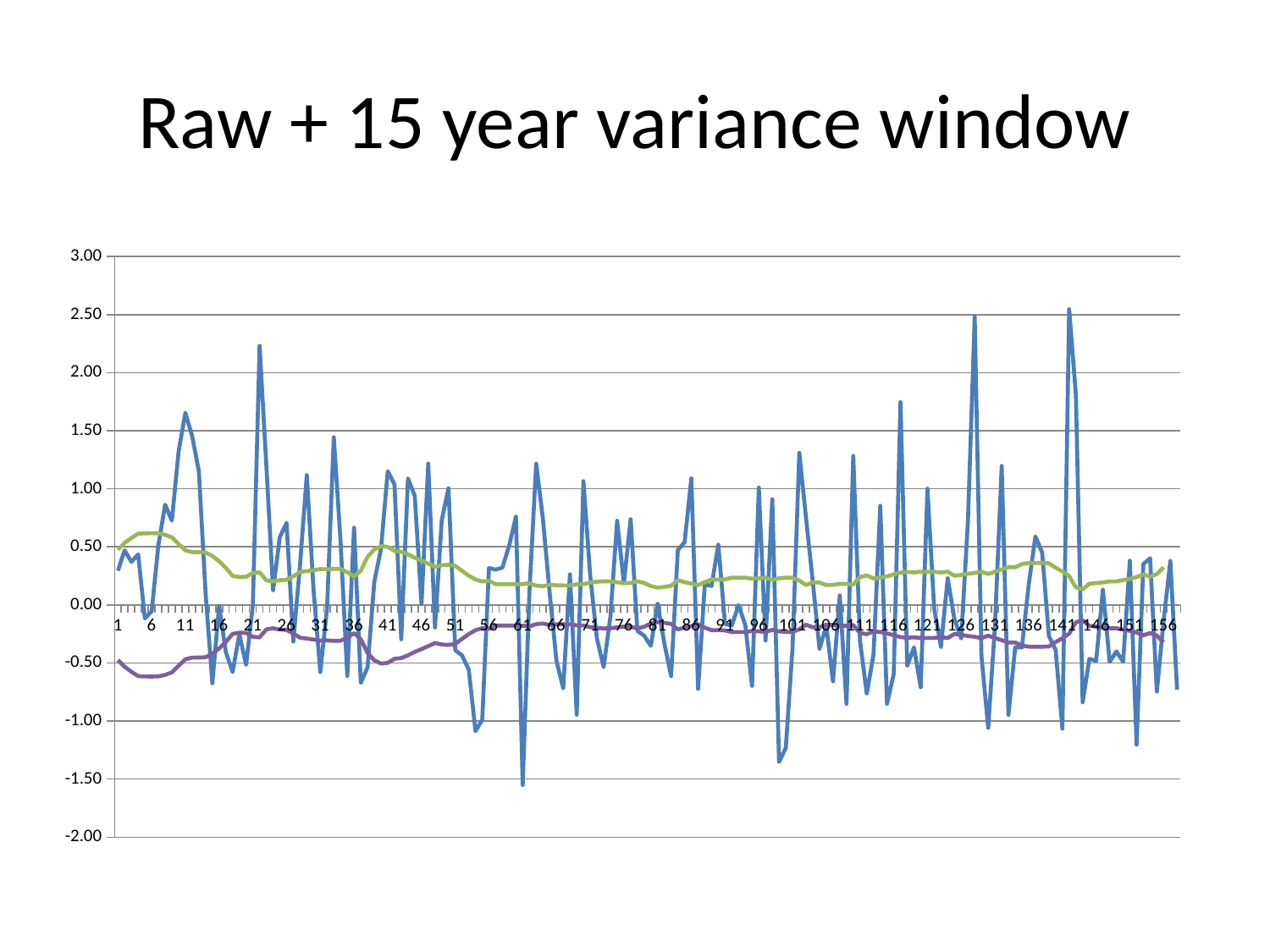
What is the lowest value labelled on the vertical axis? -2.00 Is the highest peak of the blue line, near x = 141, greater or less than 2.00? greater How many lines are plotted on the chart? 3 Does the purple line overall rise or fall from x = 1 to x = 156? rise What is the title of the chart on the slide? Raw + 15 year variance window Is the value of the purple line at x = 6 greater or less than -0.50? less Is the lowest point of the blue line, near x = 61, greater or less than -1.00? less What is the last label shown on the horizontal axis? 156 Does the green line overall rise or fall from x = 1 to x = 156? fall What kind of chart is shown on the slide? line chart What is the highest value labelled on the vertical axis? 3.00